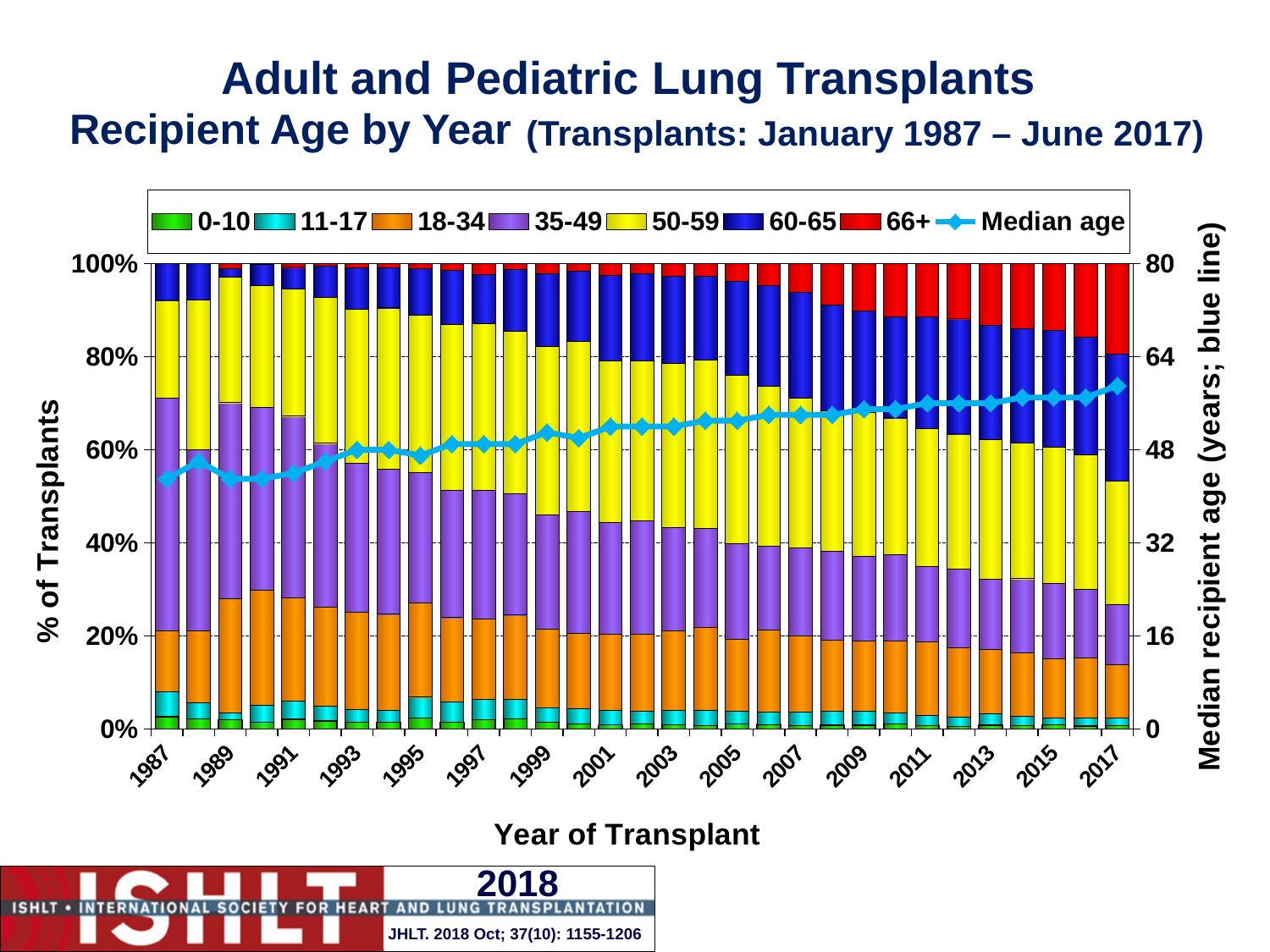
How many entries does the legend list? 8 Does the median recipient age rise or fall from 1987 to 2017? Rises Is the median recipient age larger in 2017 or in 1987? 2017 Does the share of transplants in the 66+ age group rise or fall over the years shown? Rises What is the label of the right-hand y axis? Median recipient age (years; blue line) How many years (bars) are plotted along the x axis? 31 Is the median recipient age in 2017 greater or less than 48 years? greater Which year has the highest median recipient age? 2017 Does the share of transplants in the 18-34 age group rise or fall from 1990 to 2017? Falls What kind of chart is shown on the slide? Stacked bar chart with a line Is the median recipient age in 2005 greater or less than 48 years? greater Is the median recipient age in 1987 greater or less than 48 years? less